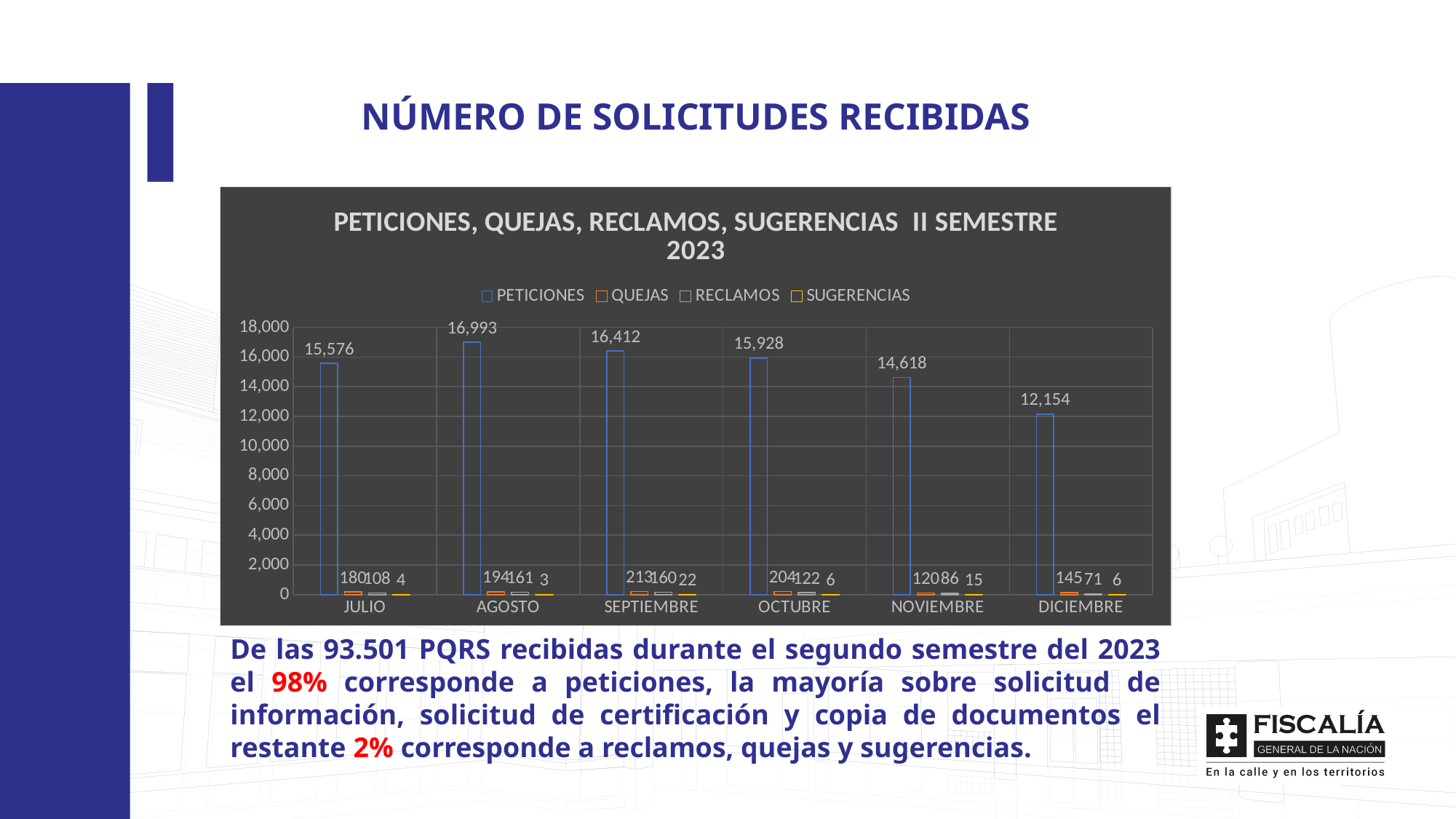
Is the PETICIONES value for DICIEMBRE greater or less than 14,000? less What kind of chart is shown on the slide? bar chart What is the difference between the PETICIONES values for AGOSTO and DICIEMBRE? 4,839 What is the value of SUGERENCIAS for SEPTIEMBRE? 22 Which month has the lowest value for PETICIONES? DICIEMBRE How many months are shown on the x axis of the chart? 6 How many series does the chart legend list? 4 What is the value of PETICIONES for AGOSTO? 16,993 What is the value of PETICIONES for NOVIEMBRE? 14,618 Do the PETICIONES values rise or fall from AGOSTO to DICIEMBRE? fall Which month has the highest value for PETICIONES? AGOSTO Which month has a larger PETICIONES value, SEPTIEMBRE or OCTUBRE? SEPTIEMBRE